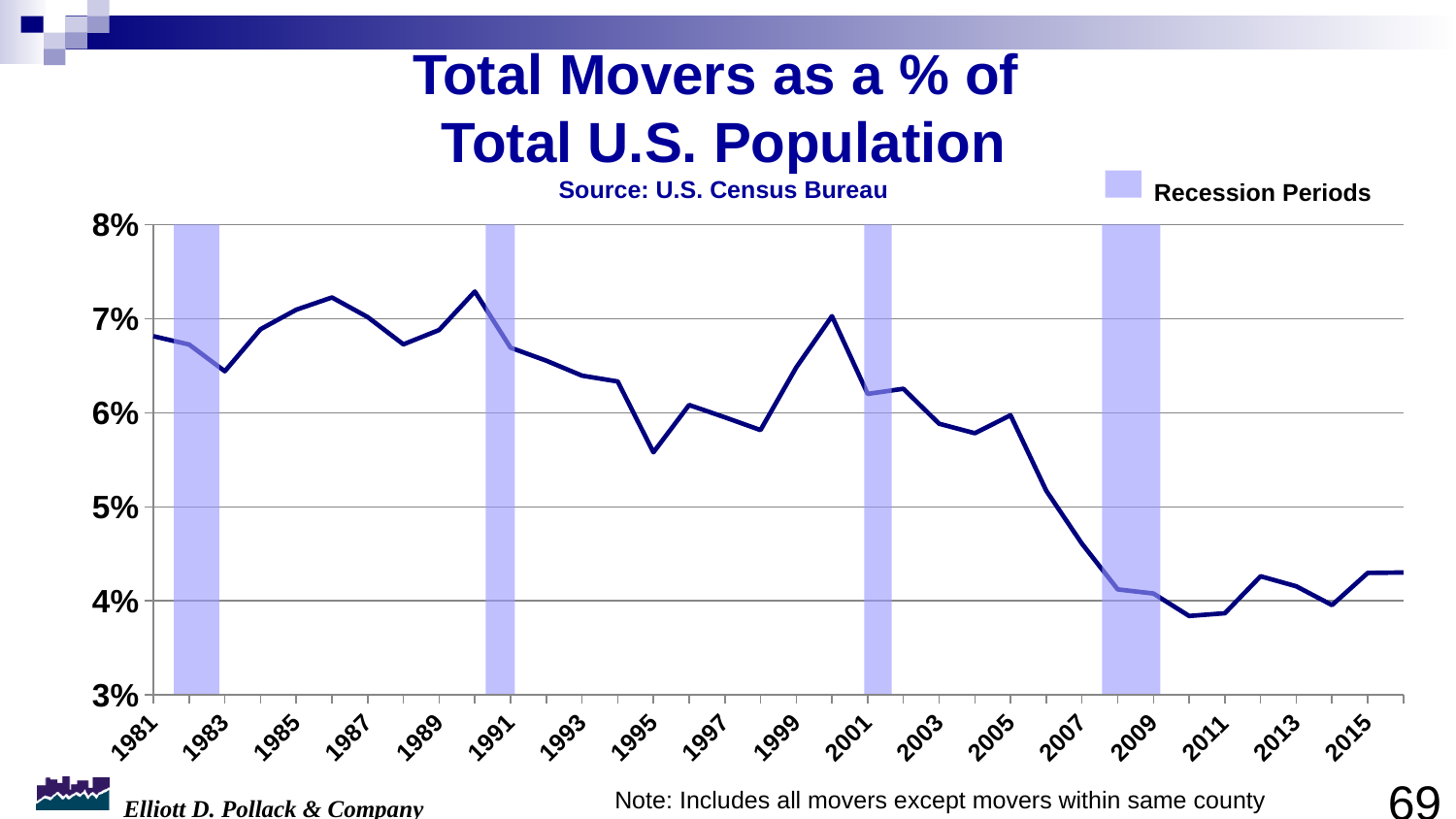
What kind of chart is shown on the slide? line chart Is the value for 1995 greater or less than 6%? less Is the value for 2015 greater or less than 4%? greater What does the shaded legend entry on the chart represent? Recession Periods How many shaded recession periods are shown on the chart? 4 What is the title of the chart? Total Movers as a % of Total U.S. Population Is the value for 2007 greater or less than 6%? less Overall, do the values rise or fall from 1981 to 2015? fall Which year has the larger value, 1981 or 2015? 1981